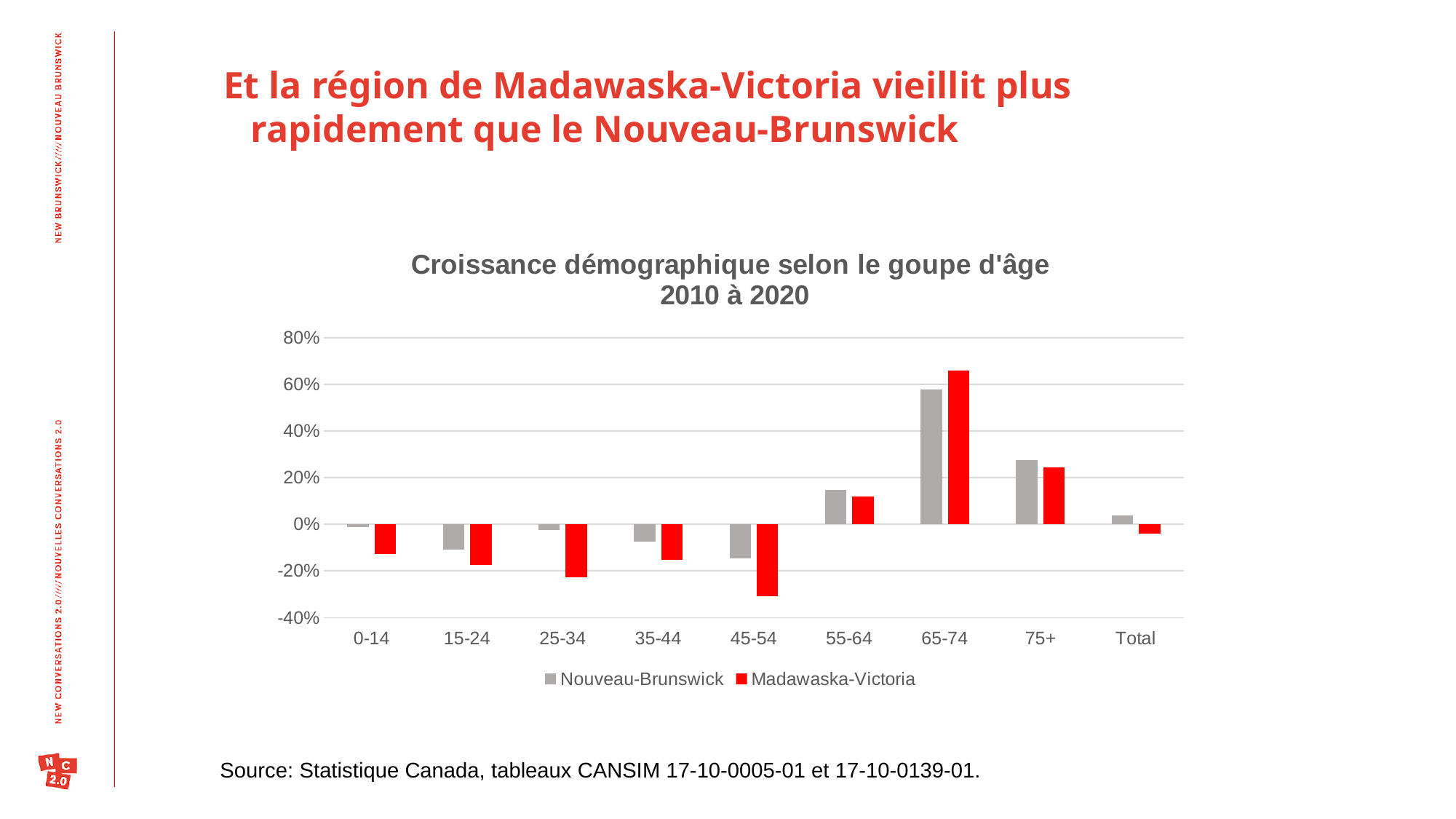
Which age group has the lowest value for Madawaska-Victoria? 45-54 What colour represents Madawaska-Victoria in the chart? red For the 65-74 age group, which series has the larger value, Nouveau-Brunswick or Madawaska-Victoria? Madawaska-Victoria Which age group has the highest value for Madawaska-Victoria? 65-74 Is the value for Madawaska-Victoria in the 65-74 age group greater or less than 60%? greater How many categories are shown on the x axis? 9 What kind of chart is shown on the slide? bar chart Is the value for Madawaska-Victoria in the 45-54 age group greater or less than -20%? less For the 45-54 age group, which series has the larger value, Nouveau-Brunswick or Madawaska-Victoria? Nouveau-Brunswick Which age group has the lowest value for Nouveau-Brunswick? 45-54 How many series does the legend list? 2 Which age group has the highest value for Nouveau-Brunswick? 65-74